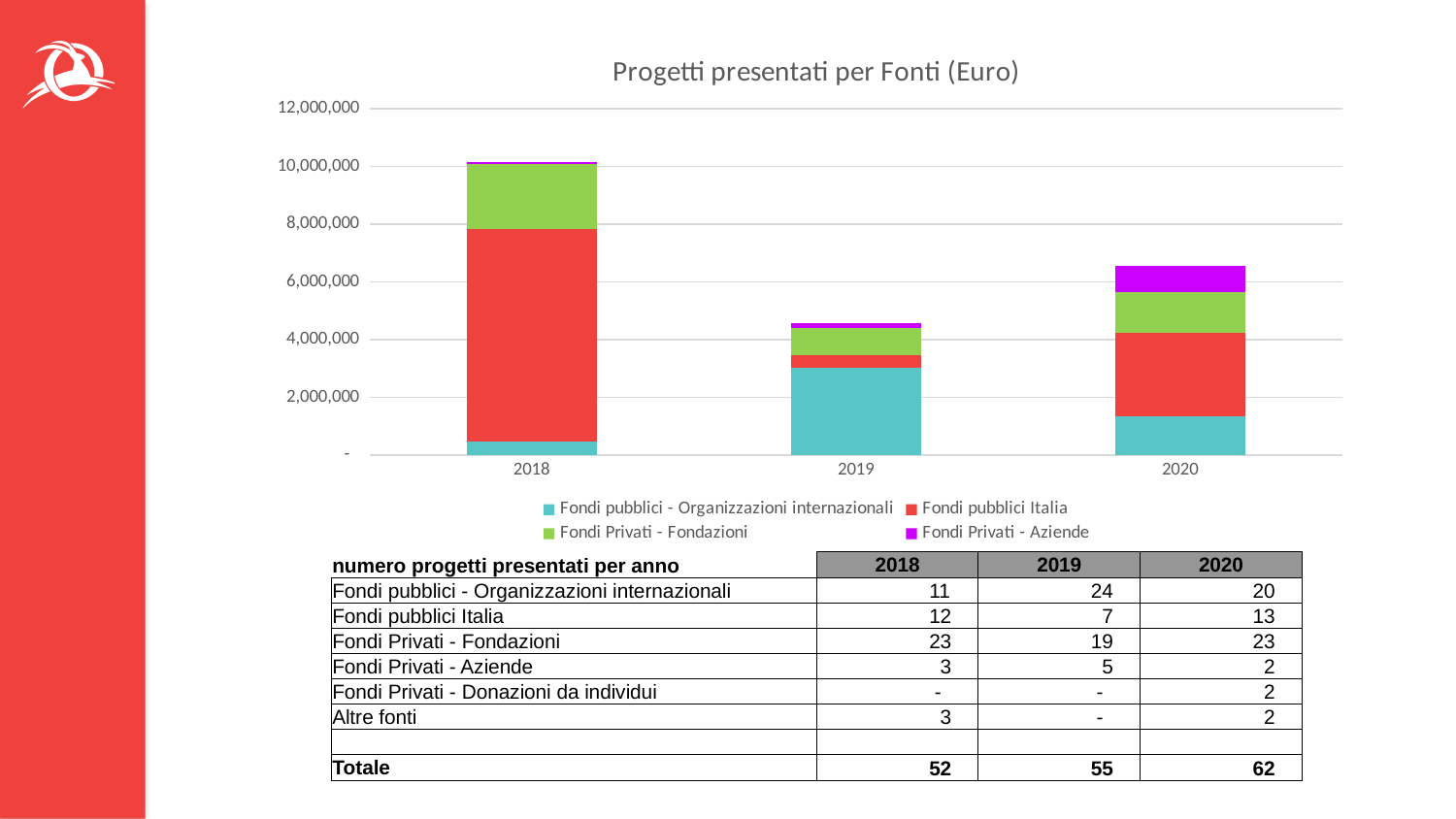
Which year has the larger total stacked bar, 2018 or 2020? 2018 Is the Fondi pubblici Italia segment for 2018 greater or less than 6,000,000? greater Which year has the lowest total stacked bar in the chart? 2019 How many series does the chart legend list? 4 What kind of chart is shown on the slide? Stacked bar chart Which legend series is shown in green in the chart? Fondi Privati - Fondazioni Is the total stacked bar for 2019 greater or less than 6,000,000? less How many years are shown on the x axis of the chart? 3 Which year has the highest total stacked bar in the chart? 2018 Is the total stacked bar for 2020 greater or less than 8,000,000? less What is the title of the chart? Progetti presentati per Fonti (Euro)